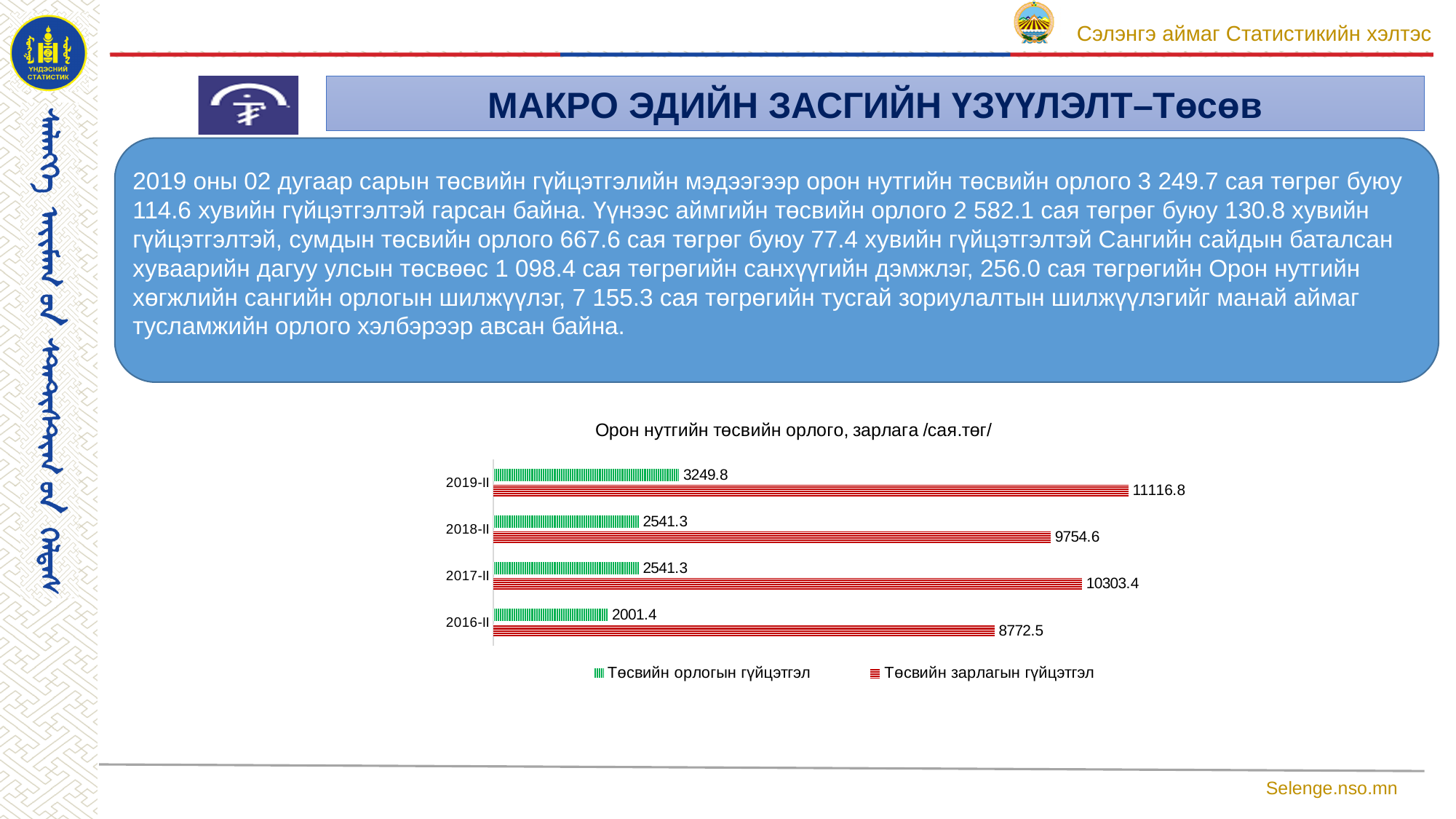
What is the difference between Төсвийн зарлагын гүйцэтгэл and Төсвийн орлогын гүйцэтгэл in 2019-II? 7867.0 What is the title of the chart? Орон нутгийн төсвийн орлого, зарлага /сая.төг/ Which is larger: Төсвийн зарлагын гүйцэтгэл in 2017-II or in 2018-II? 2017-II What kind of chart is shown on the slide? Bar chart Which period has the highest Төсвийн зарлагын гүйцэтгэл? 2019-II Which period has the lowest Төсвийн орлогын гүйцэтгэл? 2016-II What is the value of Төсвийн зарлагын гүйцэтгэл for 2016-II? 8772.5 How many periods are shown on the chart? 4 What is the value of Төсвийн зарлагын гүйцэтгэл for 2017-II? 10303.4 How many series does the legend list? 2 What is the value of Төсвийн орлогын гүйцэтгэл for 2019-II? 3249.8 What is the difference in Төсвийн орлогын гүйцэтгэл between 2019-II and 2018-II? 708.5